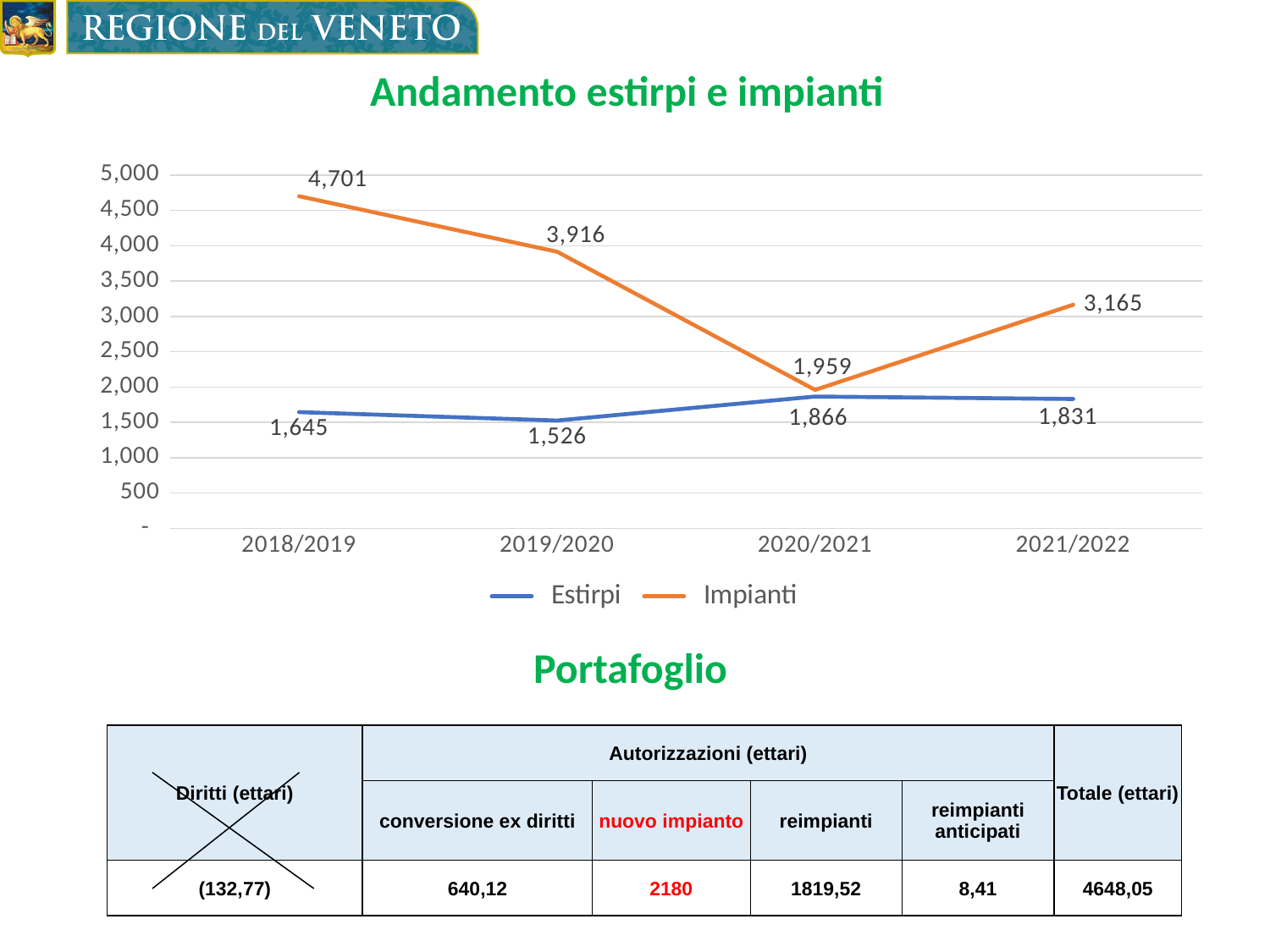
What is the value of Impianti for 2021/2022? 3,165 What is the value of Impianti for 2018/2019? 4,701 In which period is the Impianti value lowest? 2020/2021 How many series does the legend list? 2 What type of chart is shown on the slide? line chart What is the value of Estirpi for 2019/2020? 1,526 What is the title of the chart? Andamento estirpi e impianti Which is larger in 2020/2021, Estirpi or Impianti? Impianti What is the difference between Impianti and Estirpi in 2018/2019? 3,056 How many periods are shown on the x axis? 4 Does the Impianti line rise or fall from 2018/2019 to 2020/2021? fall In which period is the Estirpi value highest? 2020/2021